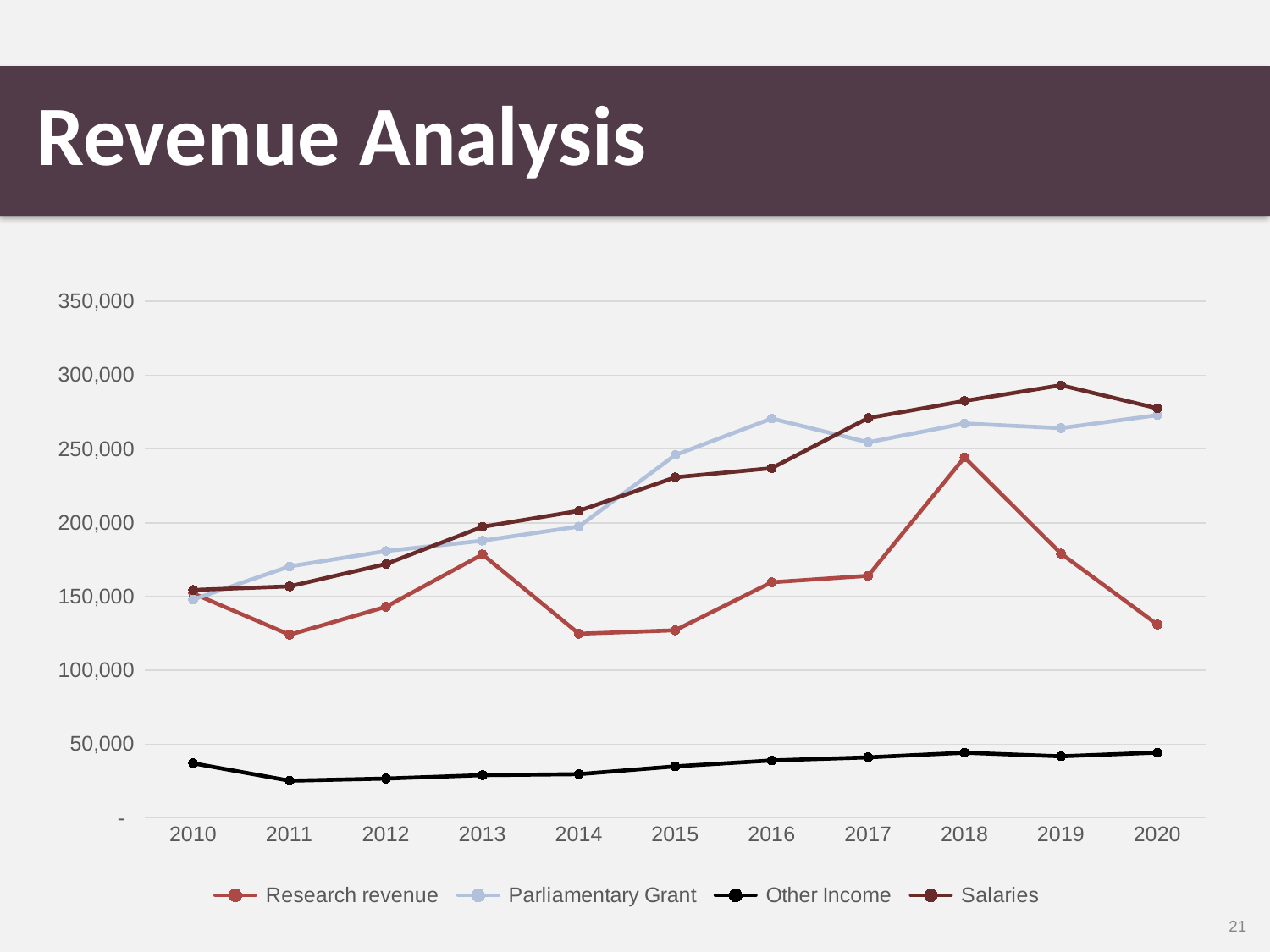
How many years are shown on the x axis? 11 In 2019, which is larger: Salaries or Parliamentary Grant? Salaries In 2016, which is larger: Parliamentary Grant or Salaries? Parliamentary Grant Is the value for Other Income in 2010 greater or less than 50,000? less What kind of chart is shown on the slide? line chart How many series does the legend list? 4 In which year do Salaries reach their highest value? 2019 In which year does Research revenue reach its highest value? 2018 Is the value for Parliamentary Grant in 2016 greater or less than 250,000? greater Which series has the lowest values across all years? Other Income Is the value for Research revenue in 2018 greater or less than 200,000? greater Do Salaries rise or fall from 2010 to 2019? rise